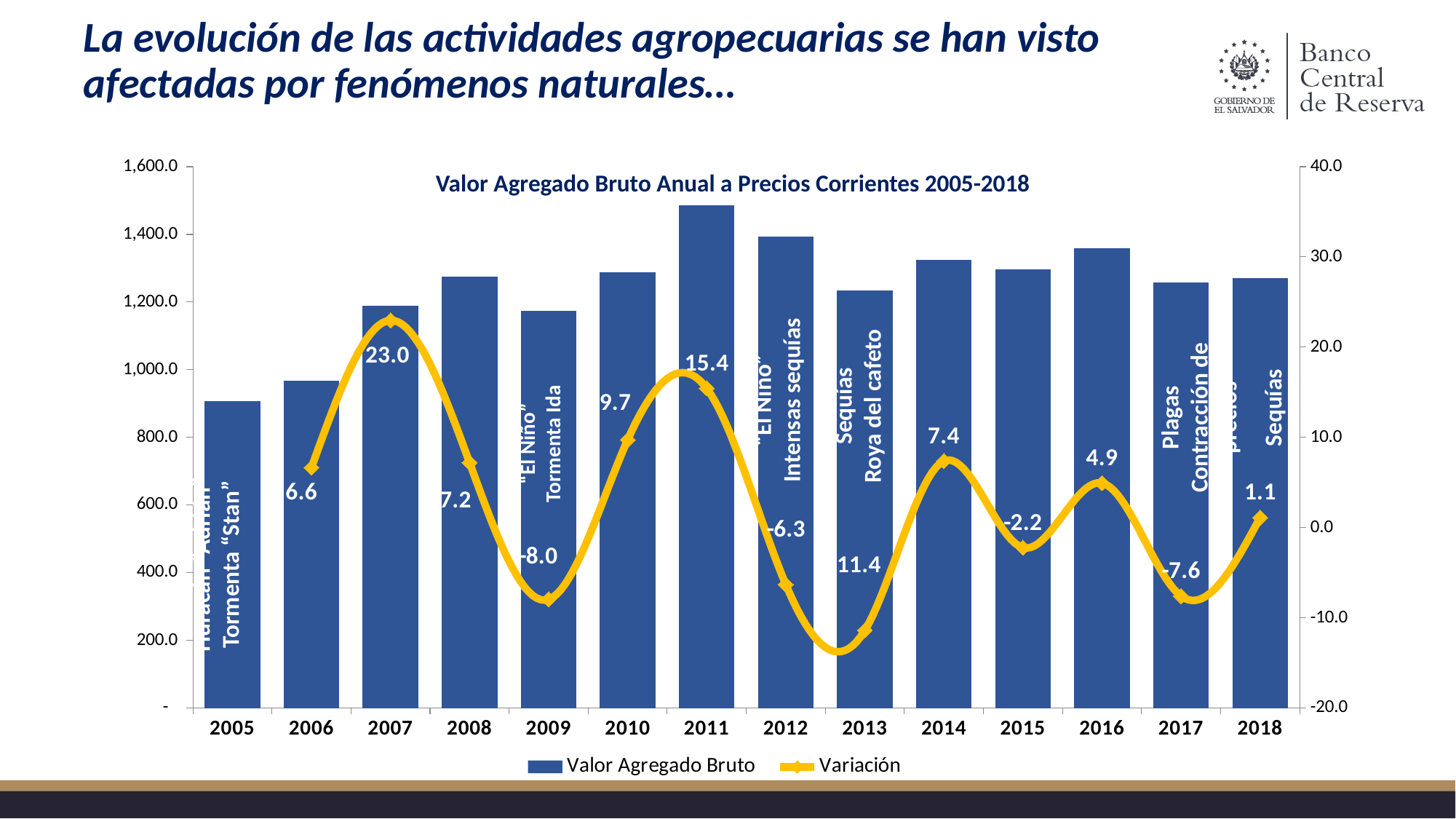
How many years are shown on the x axis? 14 Is the Valor Agregado Bruto value for 2011 greater or less than 1,400.0? greater In which year is the Variación line at its highest? 2007 What is the Variación value for 2007? 23.0 How many series does the legend list? 2 What is the difference between the Variación values for 2007 and 2006? 16.4 Is the Valor Agregado Bruto value for 2005 greater or less than 1,000.0? less Which year has a larger Variación value, 2011 or 2014? 2011 In which year is the Valor Agregado Bruto bar the tallest? 2011 In which year is the Valor Agregado Bruto bar the shortest? 2005 What is the Variación value for 2017? -7.6 What is the Variación value for 2009? -8.0